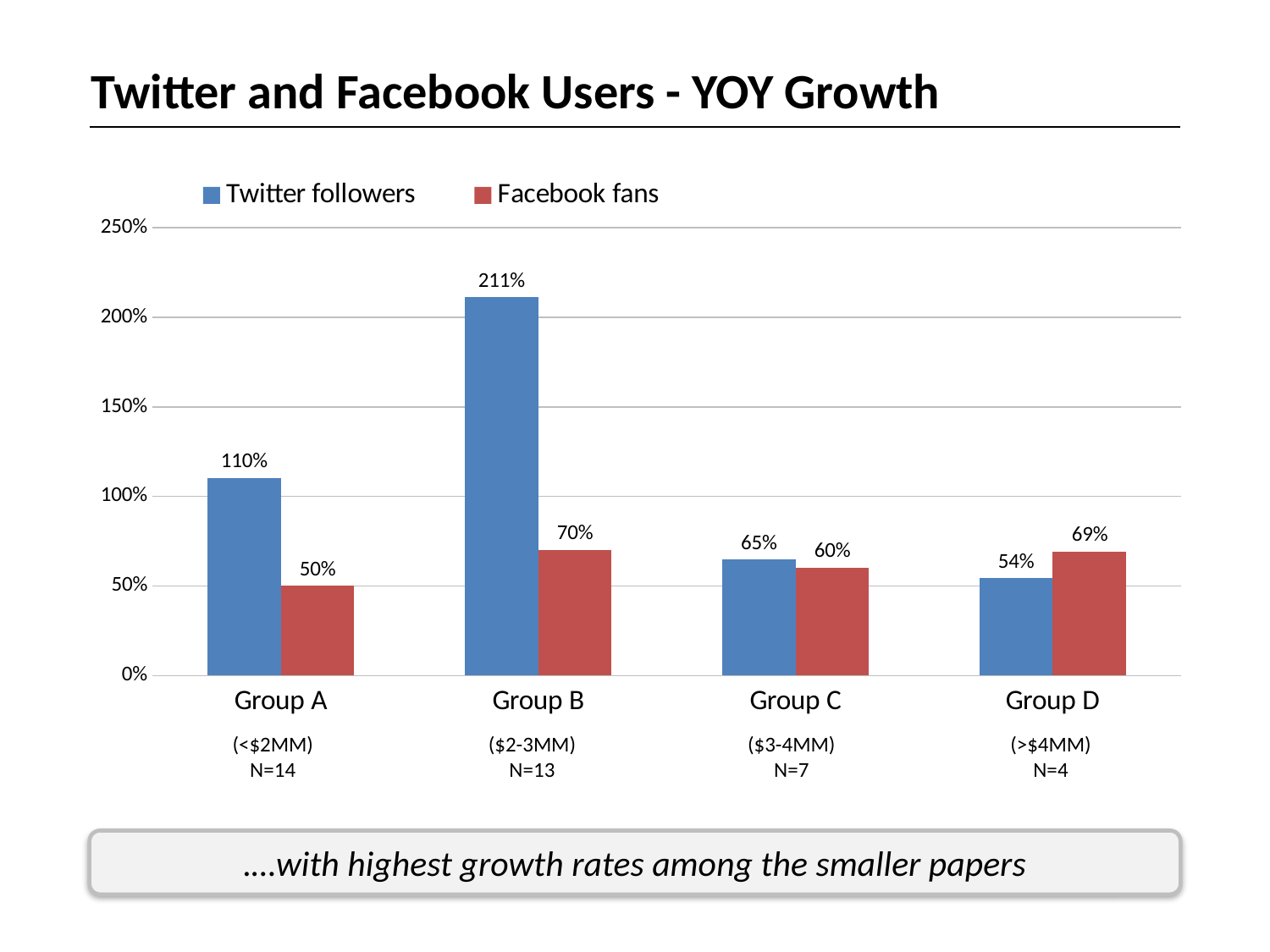
What is the Facebook fans growth for Group A? 50% What is the difference between Twitter followers growth and Facebook fans growth for Group B? 141% What is the Facebook fans growth for Group D? 69% What kind of chart is shown on the slide? Bar chart Is the Twitter followers growth for Group A greater or less than 100%? greater What is the title of the chart? Twitter and Facebook Users - YOY Growth How many series does the legend list? 2 Which group has the highest Twitter followers growth? Group B Which group has the lowest Facebook fans growth? Group A What is the Twitter followers growth for Group B? 211% For Group D, which is larger: Twitter followers growth or Facebook fans growth? Facebook fans How many groups are shown on the x axis? 4